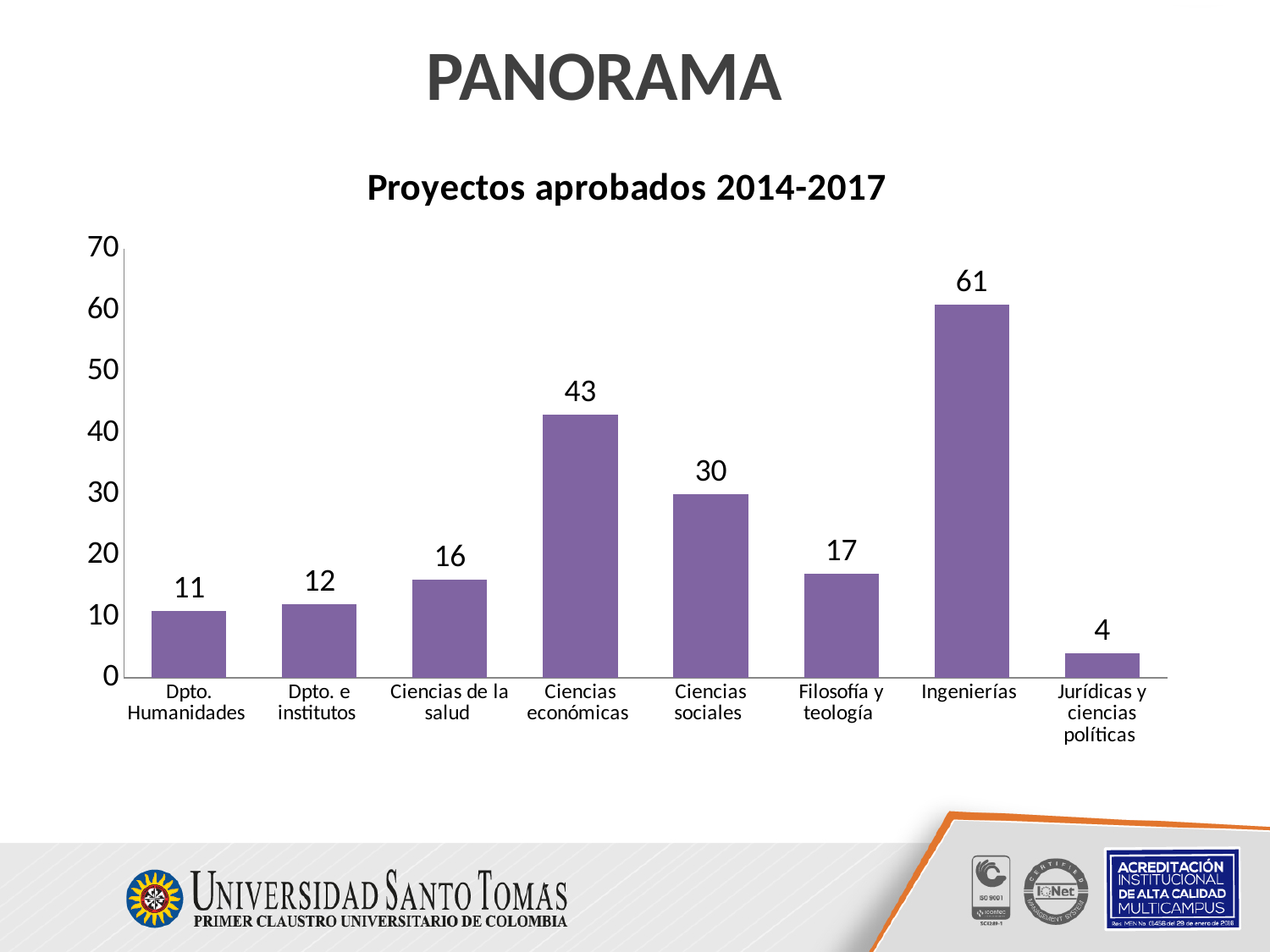
What is the title of the chart? Proyectos aprobados 2014-2017 What is the value for Ciencias económicas? 43 What is the value for Jurídicas y ciencias políticas? 4 Is the value for Ciencias de la salud greater or less than 20? less Which is larger, the value for Ciencias sociales or the value for Filosofía y teología? Ciencias sociales Which category has the lowest value? Jurídicas y ciencias políticas How many categories are shown on the x axis? 8 What is the difference between the values for Ingenierías and Ciencias económicas? 18 What is the value for Ingenierías? 61 What kind of chart is shown on the slide? bar chart Which category has the highest value? Ingenierías What is the difference between the values for Dpto. e institutos and Dpto. Humanidades? 1